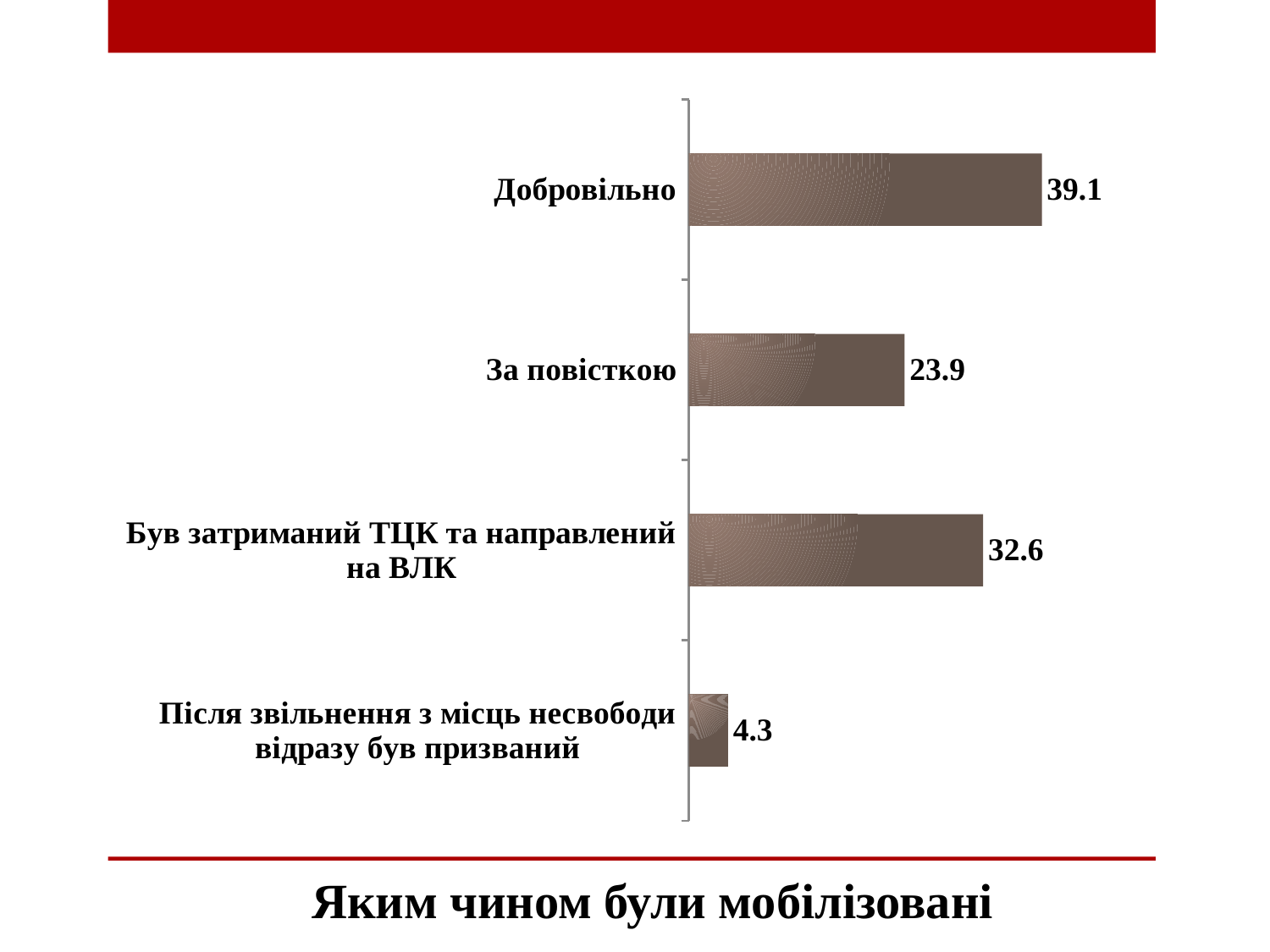
What is the difference between the values for "Був затриманий ТЦК та направлений на ВЛК" and "Після звільнення з місць несвободи відразу був призваний"? 28.3 What is the value for "Добровільно"? 39.1 How many categories are shown in the chart? 4 Which category has the lowest value? Після звільнення з місць несвободи відразу був призваний What is the value for "За повісткою"? 23.9 Which category has the highest value? Добровільно What is the value for "Був затриманий ТЦК та направлений на ВЛК"? 32.6 What is the value for "Після звільнення з місць несвободи відразу був призваний"? 4.3 Which is larger: the value for "За повісткою" or for "Був затриманий ТЦК та направлений на ВЛК"? Був затриманий ТЦК та направлений на ВЛК What is the title shown below the chart? Яким чином були мобілізовані What kind of chart is shown on the slide? bar chart What is the difference between the values for "Добровільно" and "За повісткою"? 15.2